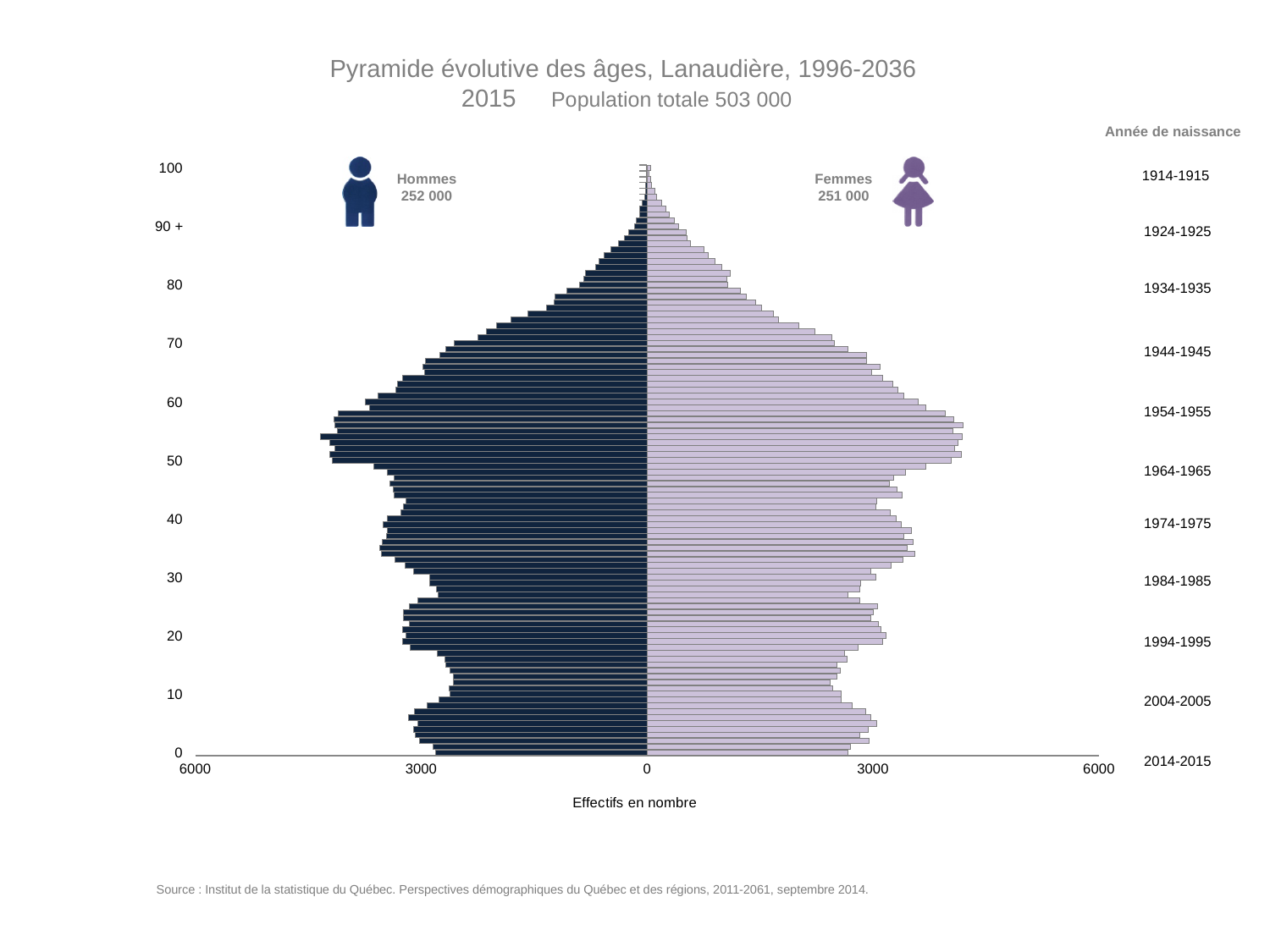
What is the difference between the number of Hommes and the number of Femmes? 1 000 What is the Population totale shown on the chart? 503 000 What is the label of the horizontal axis? Effectifs en nombre Is the value for Hommes at age 55 greater or less than 3000? greater Is the value for Femmes at age 90 greater or less than 3000? less Is the value for Femmes at age 55 greater or less than 3000? greater What is the total number of Hommes shown on the chart? 252 000 Do the bar lengths for Hommes increase or decrease from age 60 to age 100? decrease What kind of chart is shown on the slide? bar chart Which group is larger, Hommes or Femmes? Hommes What is the total number of Femmes shown on the chart? 251 000